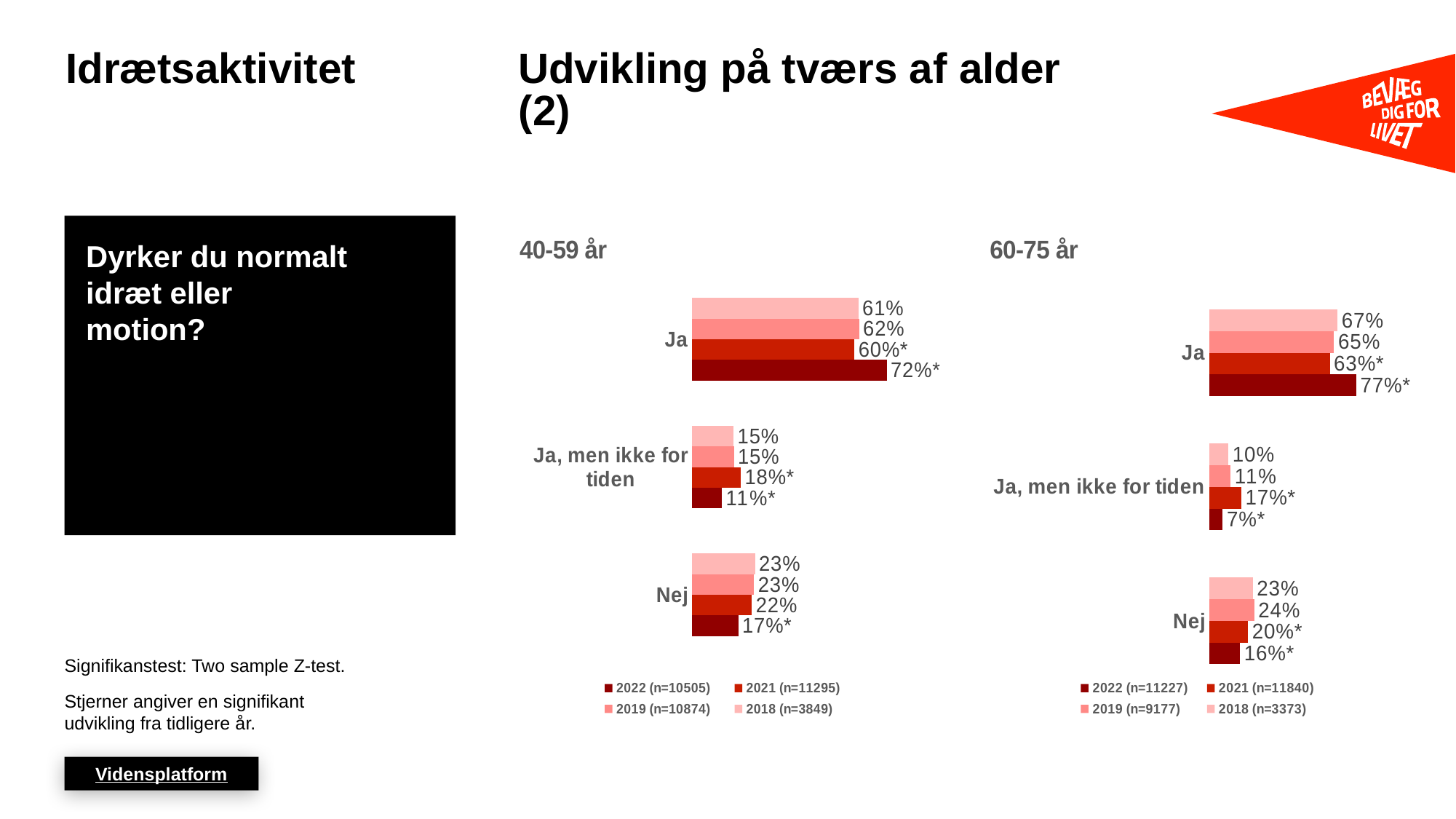
In the 60-75 år chart, what is the value for Ja, men ikke for tiden in 2021? 17%* In the 40-59 år chart, what is the value for Ja in 2022? 72%* In the 60-75 år chart, what is the difference between the 2022 and 2021 values for Ja? 14 percentage points In the 60-75 år chart, what is the value for Nej in 2019? 24% What kind of chart is the 40-59 år chart? Bar chart In the 40-59 år chart, which category has the lowest value in 2022? Ja, men ikke for tiden In the 40-59 år chart, which is larger for Nej: the 2021 value or the 2022 value? 2021 In the 40-59 år chart, what is the value for Nej in 2018? 23% What sample size does the legend of the 60-75 år chart give for 2022? n=11227 How many series does the legend of the 40-59 år chart list? 4 In the 60-75 år chart, which category has the highest value in 2022? Ja How many categories are shown in the 60-75 år chart? 3